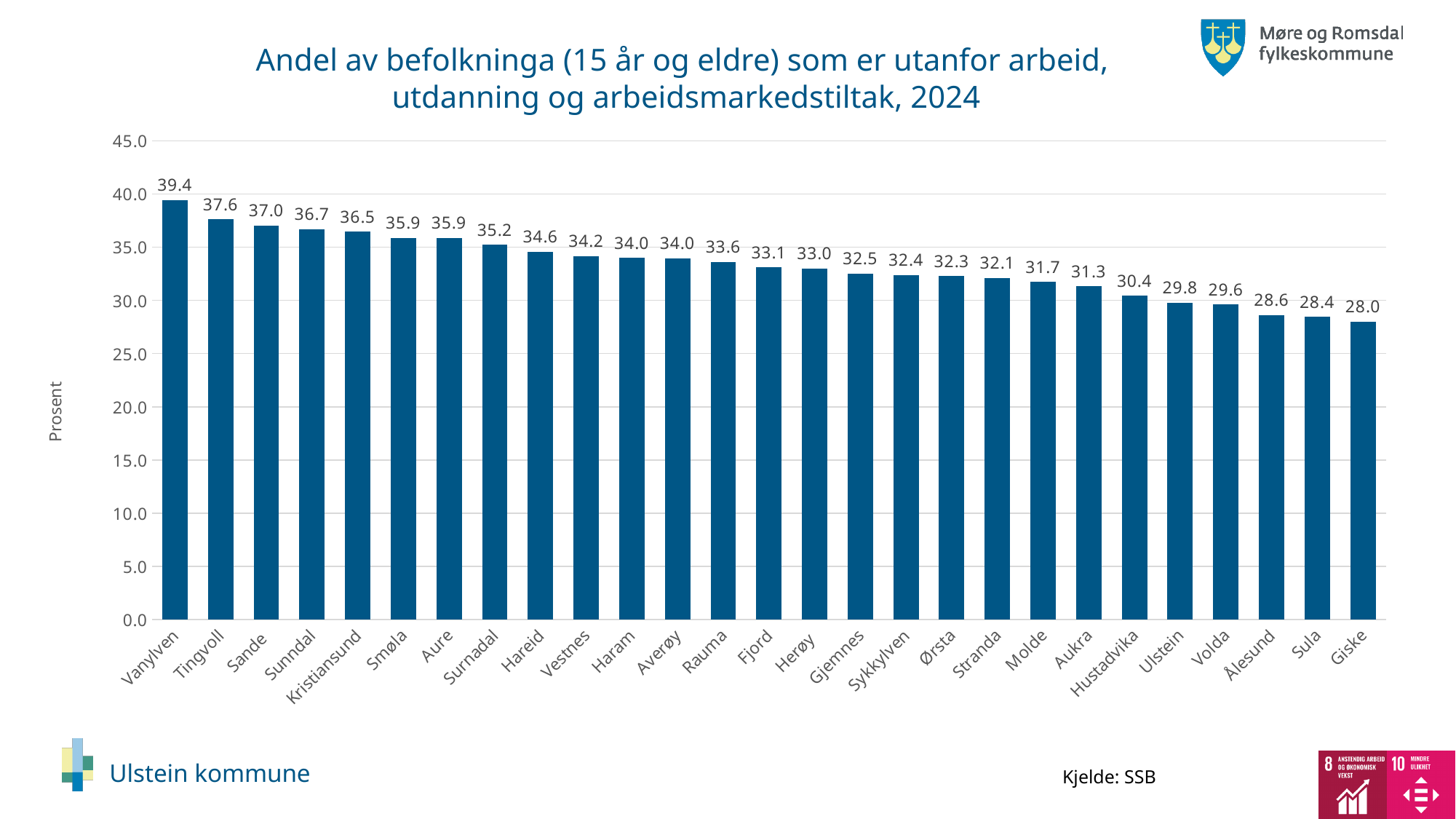
What is the difference between the values for Tingvoll and Ulstein? 7.8 Is the value for Sula greater or less than 30.0? less What is the label of the vertical axis? Prosent What is the value for Kristiansund? 36.5 How many municipalities are shown on the chart? 27 What is the value for Ulstein? 29.8 Which has a larger value, Hareid or Volda? Hareid What is the value for Molde? 31.7 Which municipality has the lowest value? Giske What kind of chart is shown on the slide? bar chart What is the difference between the values for Vanylven and Giske? 11.4 Which municipality has the highest value? Vanylven